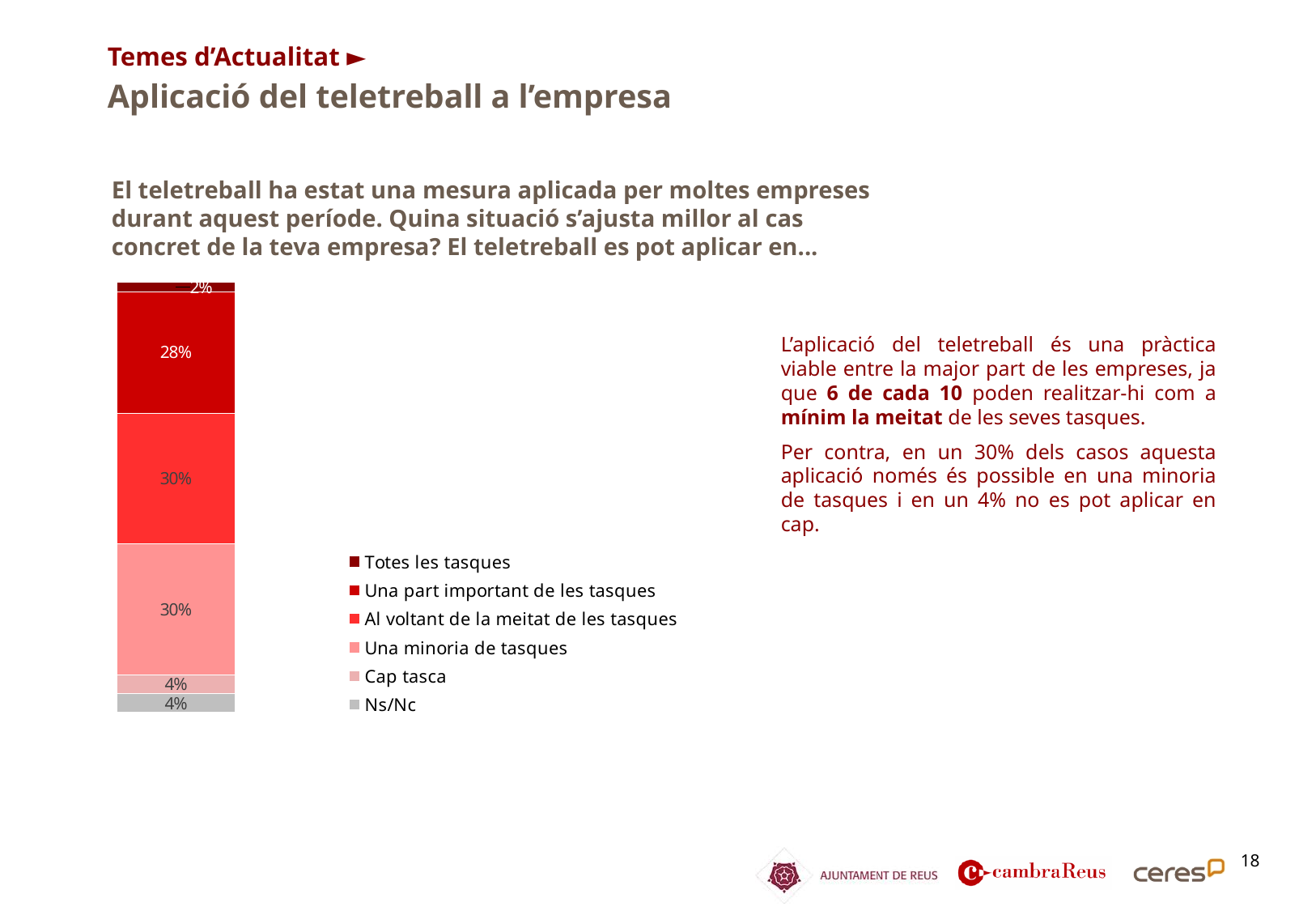
What is the value for 'Cap tasca'? 4% What is the difference between 'Una part important de les tasques' and 'Totes les tasques'? 26 percentage points What kind of chart is shown on the slide? Stacked bar chart What is the value for 'Ns/Nc'? 4% What is the value shown for 'Totes les tasques'? 2% How many series does the legend list? 6 What percentage corresponds to 'Una minoria de tasques'? 30% Which is larger: 'Al voltant de la meitat de les tasques' or 'Cap tasca'? Al voltant de la meitat de les tasques Which response category has the smallest share in the stacked bar? Totes les tasques What percentage of companies answered 'Una part important de les tasques'? 28% Which legend entry is shown in grey? Ns/Nc Which is larger: 'Una part important de les tasques' or 'Ns/Nc'? Una part important de les tasques